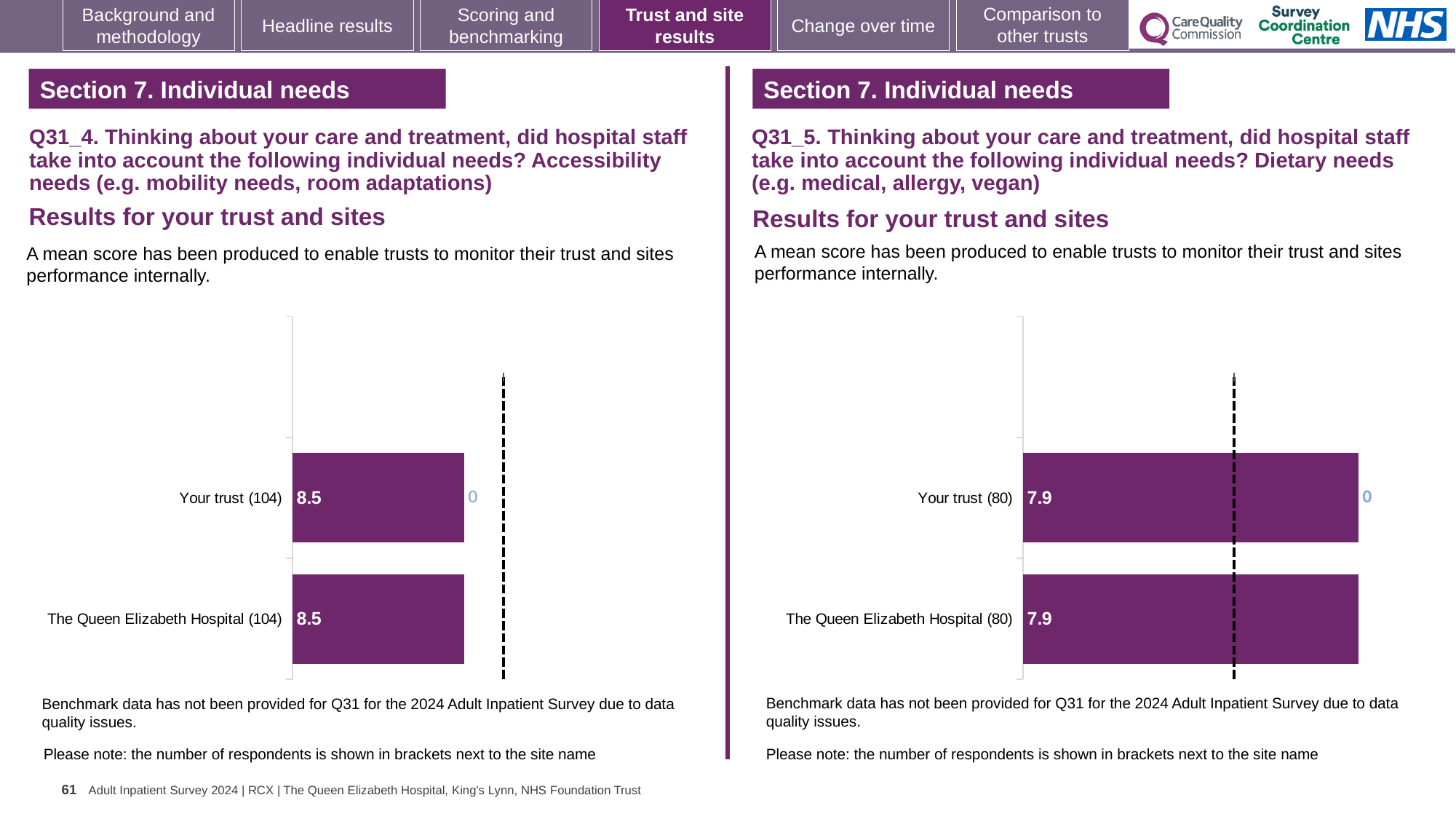
On the right chart (Q31_5, dietary needs), what is the mean score for Your trust? 7.9 On the left chart (Q31_4), how many respondents are shown in brackets next to Your trust? 104 On the left chart (Q31_4, accessibility needs), what is the mean score for The Queen Elizabeth Hospital? 8.5 On the left chart (Q31_4), what is the difference between the score for Your trust and the score for The Queen Elizabeth Hospital? 0.0 How many bars are plotted on the right chart (Q31_5)? 2 On the left chart (Q31_4, accessibility needs), what is the mean score for Your trust? 8.5 What kind of chart is used on the left side of the slide (Q31_4)? Bar chart On the right chart (Q31_5), what is the difference between the score for Your trust and the score for The Queen Elizabeth Hospital? 0.0 On the right chart (Q31_5, dietary needs), what is the mean score for The Queen Elizabeth Hospital? 7.9 Is the score for Your trust on the right chart (Q31_5) higher or lower than the score for Your trust on the left chart (Q31_4)? Lower On the right chart (Q31_5), how many respondents are shown in brackets next to The Queen Elizabeth Hospital? 80 How many bars are plotted on the left chart (Q31_4)? 2